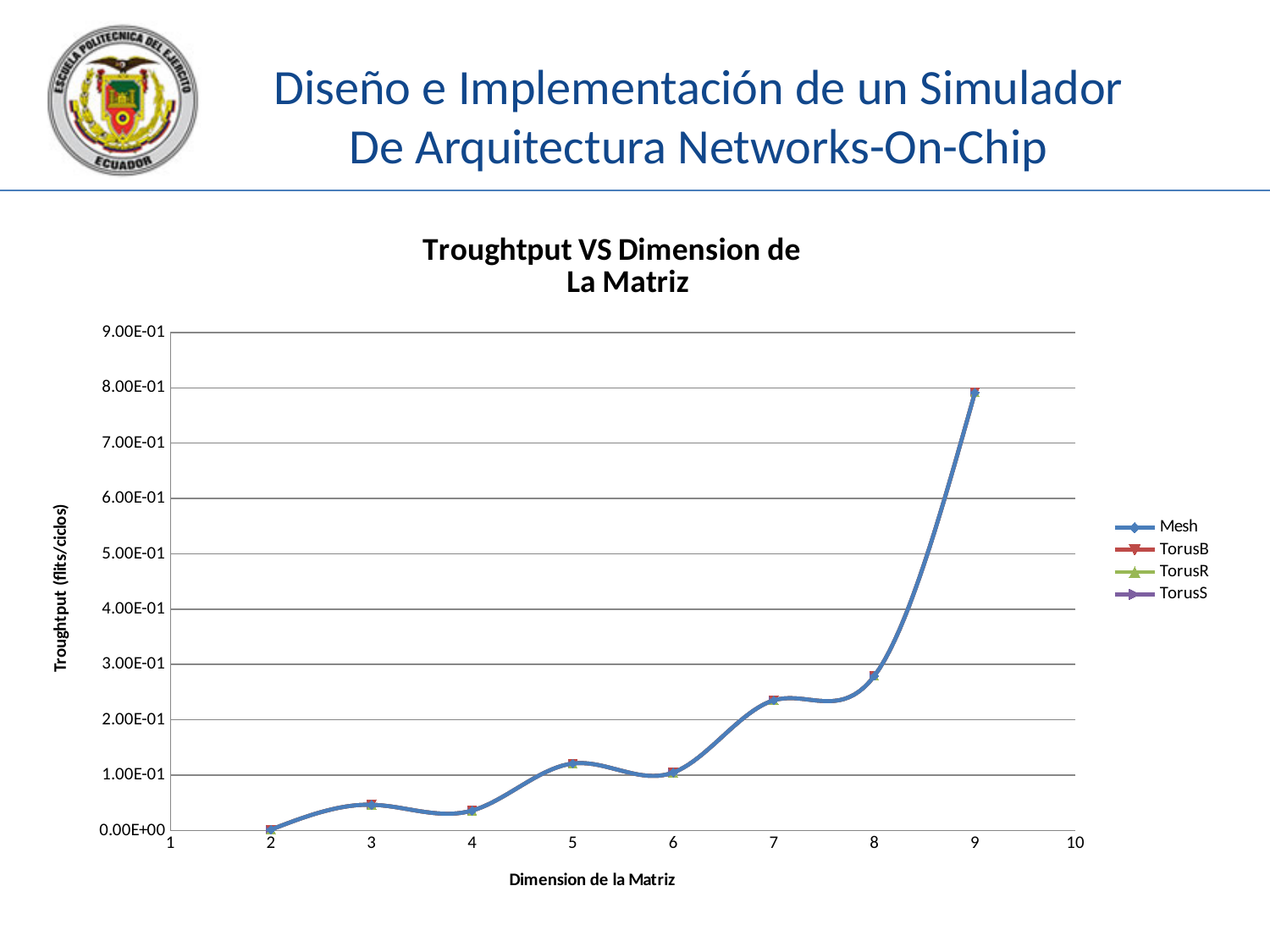
Is the throughput at dimension 7 greater or less than 2.00E-01? greater What is the title of the chart? Troughtput VS Dimension de La Matriz How many series does the legend list? 4 Is the throughput at dimension 8 greater or less than 3.00E-01? less How many data points are plotted along the x axis for each series? 8 What are the names of the series listed in the legend? Mesh, TorusB, TorusR, TorusS What kind of chart is shown on the slide? line chart Which has the higher throughput, dimension 4 or dimension 5? dimension 5 At which matrix dimension is the throughput lowest? 2 Overall, does the throughput rise or fall as the matrix dimension increases from 2 to 9? rise At which matrix dimension is the throughput highest? 9 Is the throughput at dimension 9 greater or less than 7.00E-01? greater